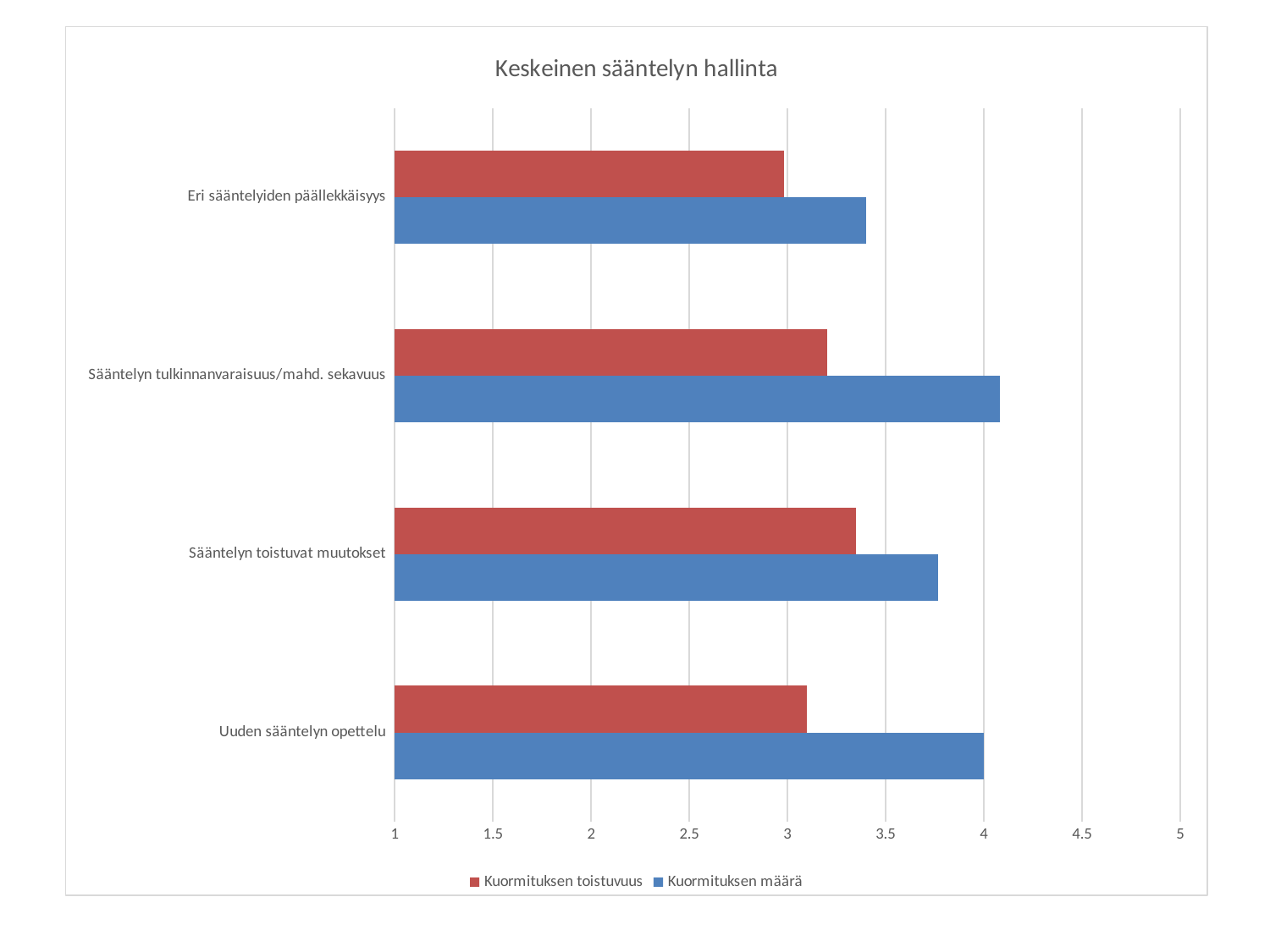
Which category has the lowest value for Kuormituksen määrä? Eri sääntelyiden päällekkäisyys What is the title of the chart? Keskeinen sääntelyn hallinta What type of chart is shown on the slide? Bar chart Which category has the highest value for Kuormituksen toistuvuus? Sääntelyn toistuvat muutokset Is the Kuormituksen toistuvuus value for Eri sääntelyiden päällekkäisyys greater or less than 3.5? less Is the Kuormituksen määrä value for Sääntelyn tulkinnanvaraisuus/mahd. sekavuus greater or less than 3.5? greater For Uuden sääntelyn opettelu, which is larger: Kuormituksen toistuvuus or Kuormituksen määrä? Kuormituksen määrä Which series is shown in blue? Kuormituksen määrä For Sääntelyn tulkinnanvaraisuus/mahd. sekavuus, which is larger: Kuormituksen toistuvuus or Kuormituksen määrä? Kuormituksen määrä How many categories are shown on the chart? 4 Is the Kuormituksen määrä value for Sääntelyn toistuvat muutokset greater or less than 3.5? greater How many series does the legend list? 2